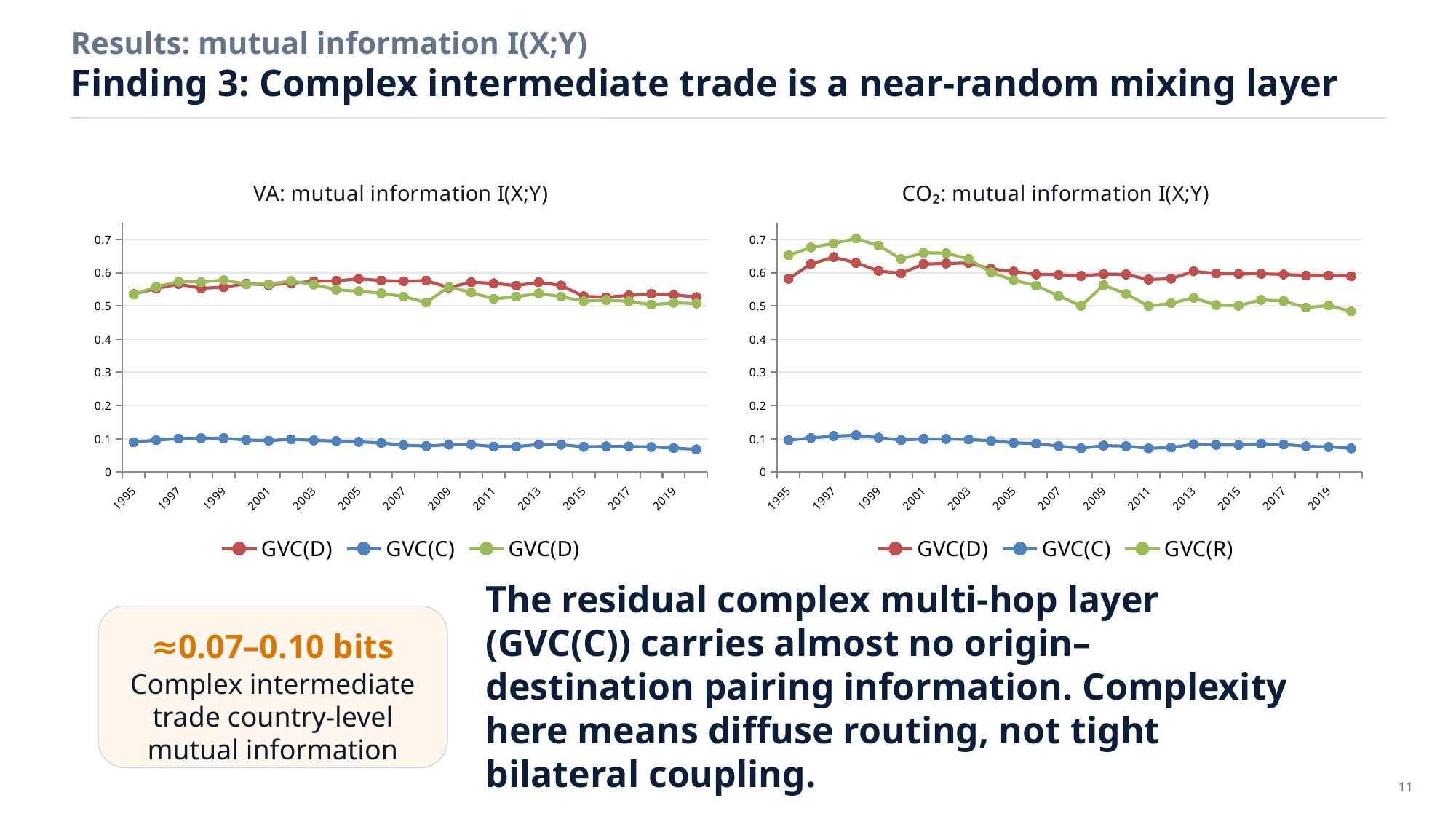
What kind of chart is the 'VA: mutual information I(X;Y)' chart? line chart In the 'VA: mutual information I(X;Y)' chart, is the value for GVC(C) in 2005 greater or less than 0.2? less In the 'VA: mutual information I(X;Y)' chart, which series has the lowest values throughout the period? GVC(C) How many year labels are shown on the x axis of the 'VA: mutual information I(X;Y)' chart? 13 What is the title of the chart on the right of the slide? CO₂: mutual information I(X;Y) In the 'CO₂: mutual information I(X;Y)' chart, which series has the higher value in 2019, GVC(D) or GVC(R)? GVC(D) In the 'CO₂: mutual information I(X;Y)' chart, is the value for GVC(D) in 1997 greater or less than 0.6? greater How many series does the legend of the 'CO₂: mutual information I(X;Y)' chart list? 3 In the 'CO₂: mutual information I(X;Y)' chart, does the GVC(R) series generally rise or fall from 1995 to 2019? fall In the 'CO₂: mutual information I(X;Y)' chart, is the value for GVC(R) in 2019 greater or less than 0.6? less In the 'CO₂: mutual information I(X;Y)' chart, which series has the higher value in 1997, GVC(R) or GVC(C)? GVC(R) In the 'CO₂: mutual information I(X;Y)' chart, which series does the legend list last? GVC(R)